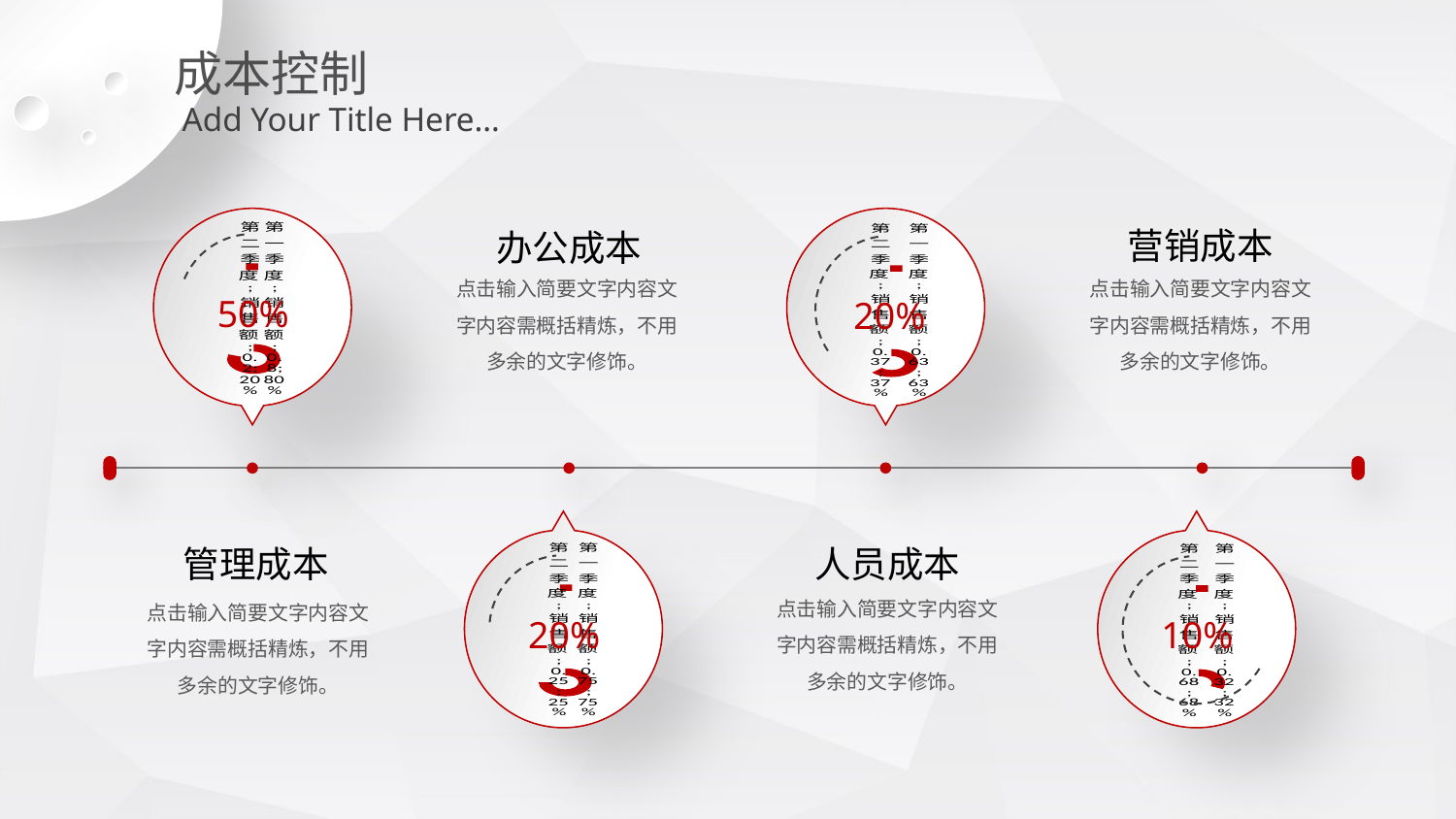
In the 人员成本 chart, which quarter has the larger share, 第一季度 or 第二季度? 第二季度 In the 管理成本 chart, what share is labelled for 第一季度? 75% What kind of chart is used inside each of the four circles on the slide? doughnut chart In the 营销成本 chart, what share is labelled for 第一季度? 63% In the 办公成本 chart, what is the difference in percentage points between the 第一季度 share and the 第二季度 share? 60 In the 人员成本 chart, what share is labelled for 第二季度? 68% What large percentage is printed over the 人员成本 chart? 10% How many slices does each doughnut chart on the slide have? 2 How many charts are shown on the slide? 4